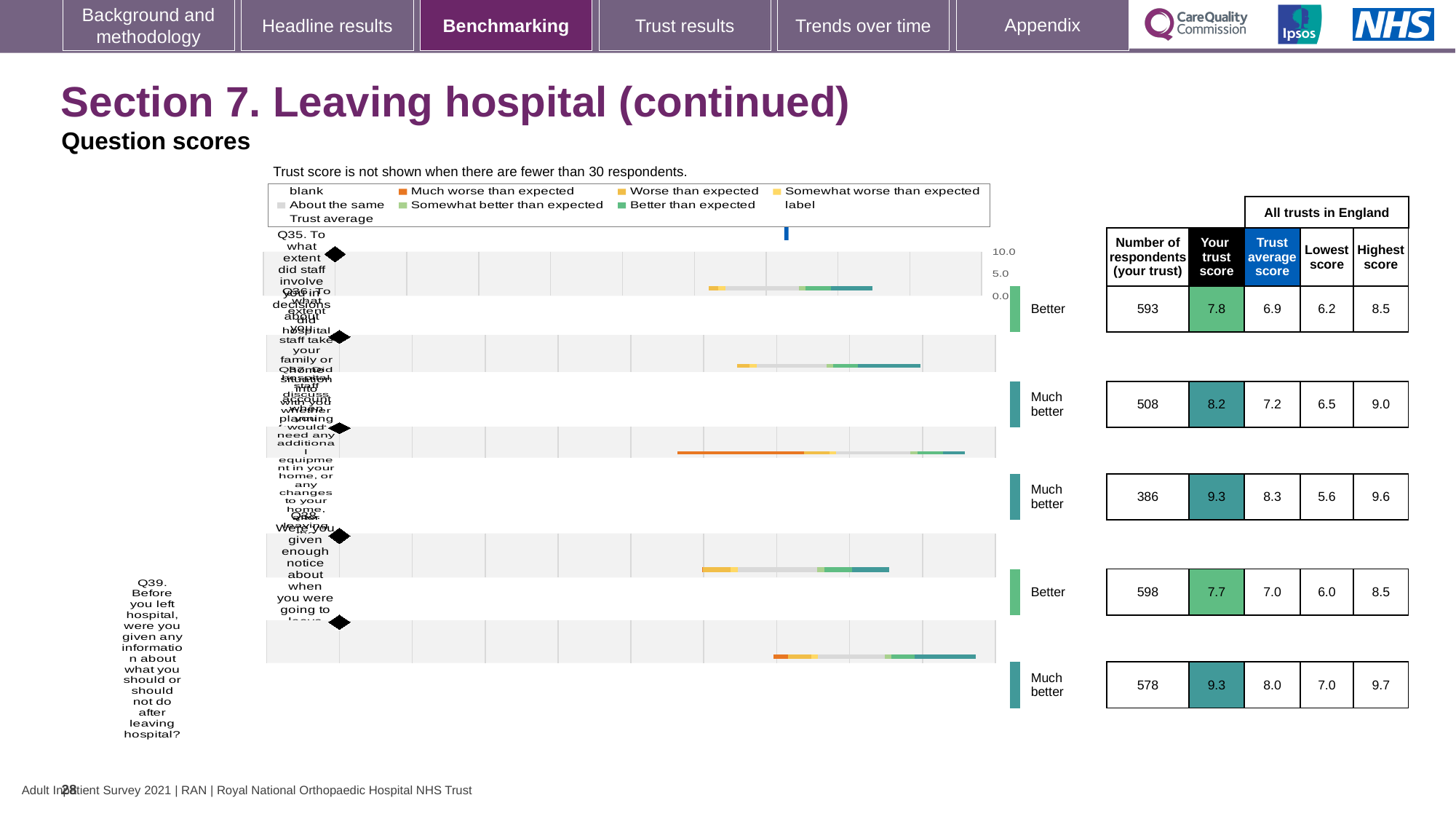
What is the largest number of respondents shown in the table for any question? 598 What is the 'Your trust score' for Q35 (To what extent did staff involve you in decisions about you leaving hospital)? 7.8 What is the highest score across all trusts in England for Q39? 9.7 What is the trust average score for Q35? 6.9 What is the smallest number of respondents shown in the table for any question? 386 How many respondents from your trust answered Q35? 593 How many questions are plotted on the chart? 5 What is the 'Your trust score' for Q39 (Before you left hospital, were you given any information about what you should or should not do after leaving hospital)? 9.3 What benchmark rating is shown next to Q39? Much better Which question has the higher 'Your trust score', Q35 or Q39? Q39 By how much does your trust score for Q35 exceed the trust average score for Q35? 0.9 What kind of chart is used to show the question scores? Bar chart